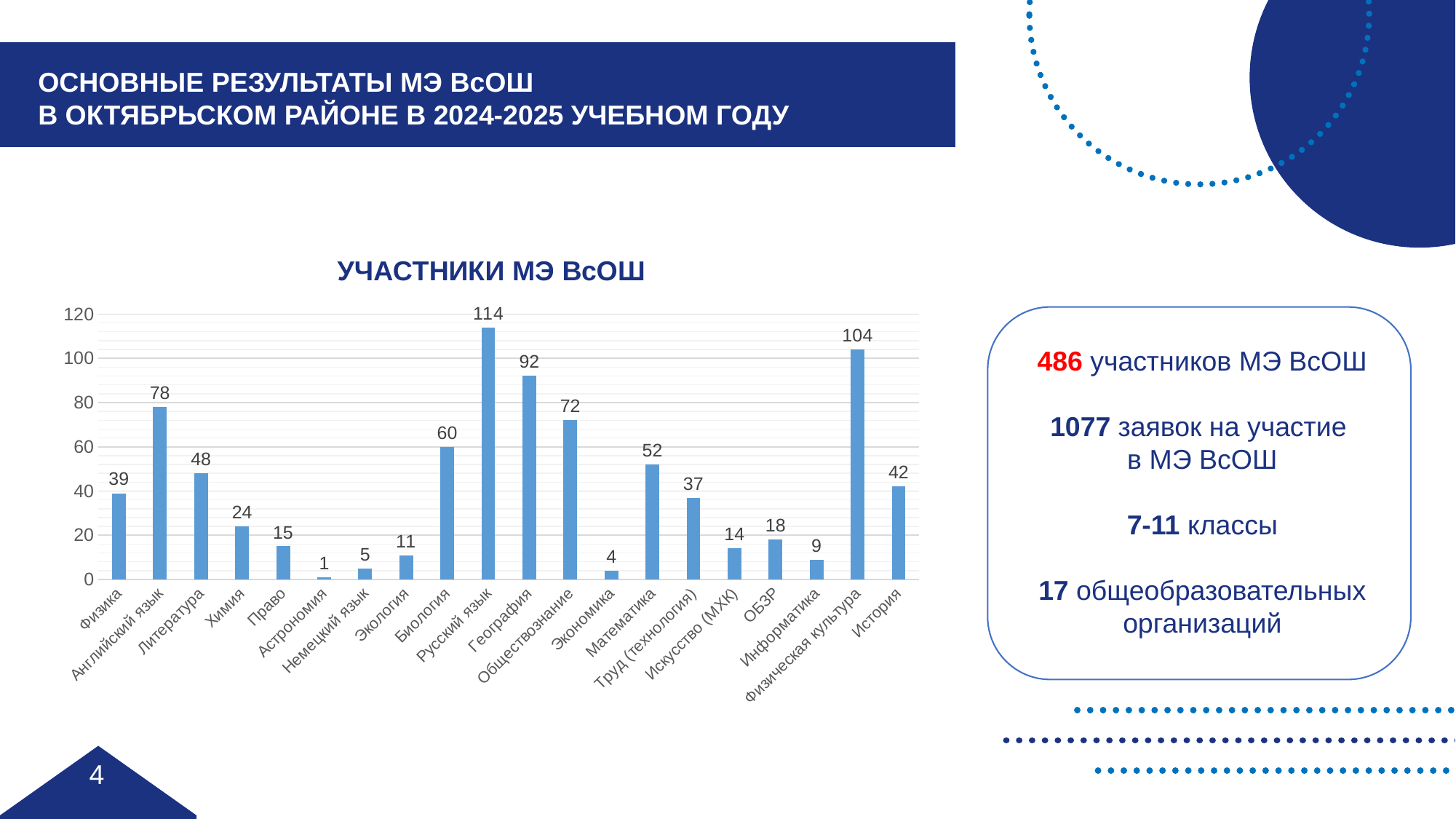
Which category has the highest value? Русский язык What is the value for Астрономия? 1 What kind of chart is this? bar chart Which category has the lowest value? Астрономия What is the title of the chart? УЧАСТНИКИ МЭ ВсОШ What is the value for Физическая культура? 104 What is the value for Русский язык? 114 What is the difference between the values for Русский язык and Физическая культура? 10 How many categories are shown on the x axis? 20 What is the difference between the values for География and Обществознание? 20 What is the value for Труд (технология)? 37 Which is larger, the value for Биология or the value for Математика? Биология